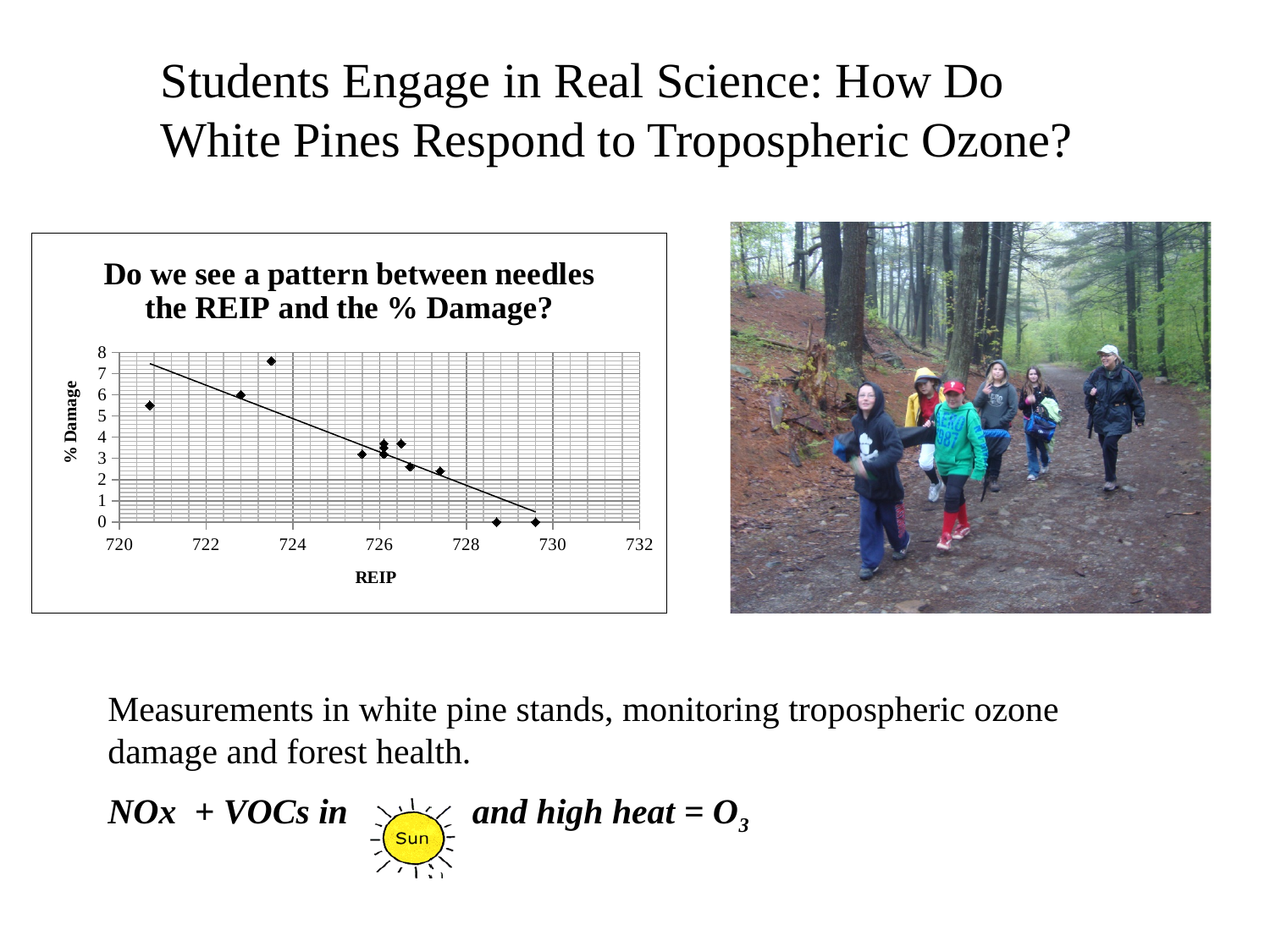
How many points on the chart have a % Damage value of 0? 2 Is the REIP value of the point with the highest % Damage greater or less than 726? less Is the % Damage value for the point at REIP about 722.8 greater or less than 5? greater What is the lowest % Damage value plotted on the chart? 0 Is the % Damage value for the point at REIP about 727.4 greater or less than 3? less What kind of chart is shown on the slide? scatter chart What is the title of the chart? Do we see a pattern between needles the REIP and the % Damage? What is the label of the x axis of the chart? REIP As REIP increases along the x axis, does % Damage generally rise or fall? fall Which has the higher % Damage: the point at REIP about 723.5 or the point at REIP about 727.4? the point at REIP about 723.5